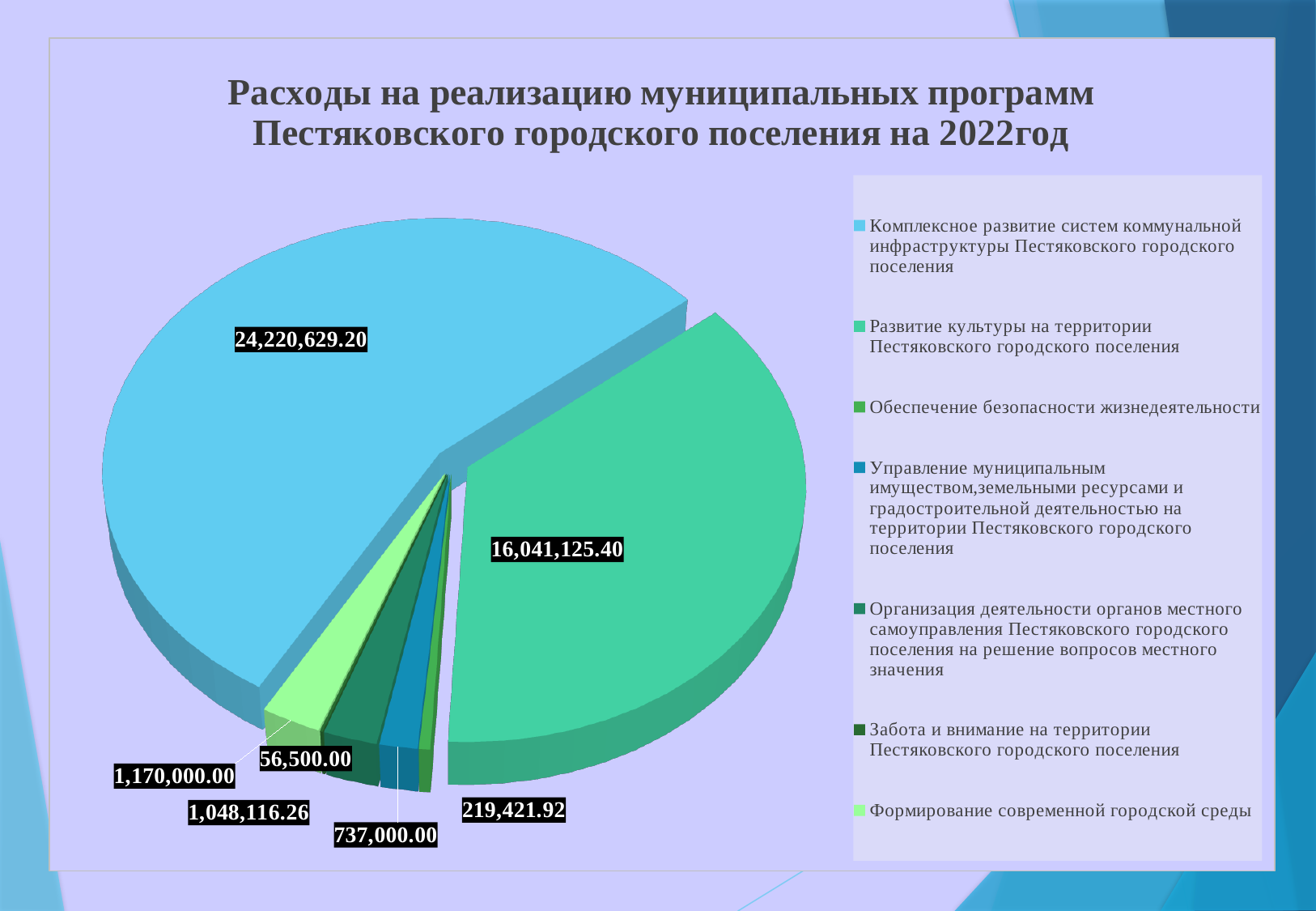
What is the value for «Развитие культуры на территории Пестяковского городского поселения»? 16,041,125.40 What is the smallest value labelled on the pie chart? 56,500.00 Which programme has the largest share of expenditure in the pie chart? Комплексное развитие систем коммунальной инфраструктуры Пестяковского городского поселения What is the value for «Комплексное развитие систем коммунальной инфраструктуры Пестяковского городского поселения»? 24,220,629.20 Which is larger: the value for «Комплексное развитие систем коммунальной инфраструктуры» or for «Развитие культуры»? Комплексное развитие систем коммунальной инфраструктуры What is the difference between the values for «Комплексное развитие систем коммунальной инфраструктуры» and «Развитие культуры»? 8,179,503.80 What kind of chart is shown on the slide? pie chart What colour is the largest slice of the pie chart? light blue How many slices does the pie chart have? 7 What is the title of the chart? Расходы на реализацию муниципальных программ Пестяковского городского поселения на 2022год How many entries does the legend list? 7